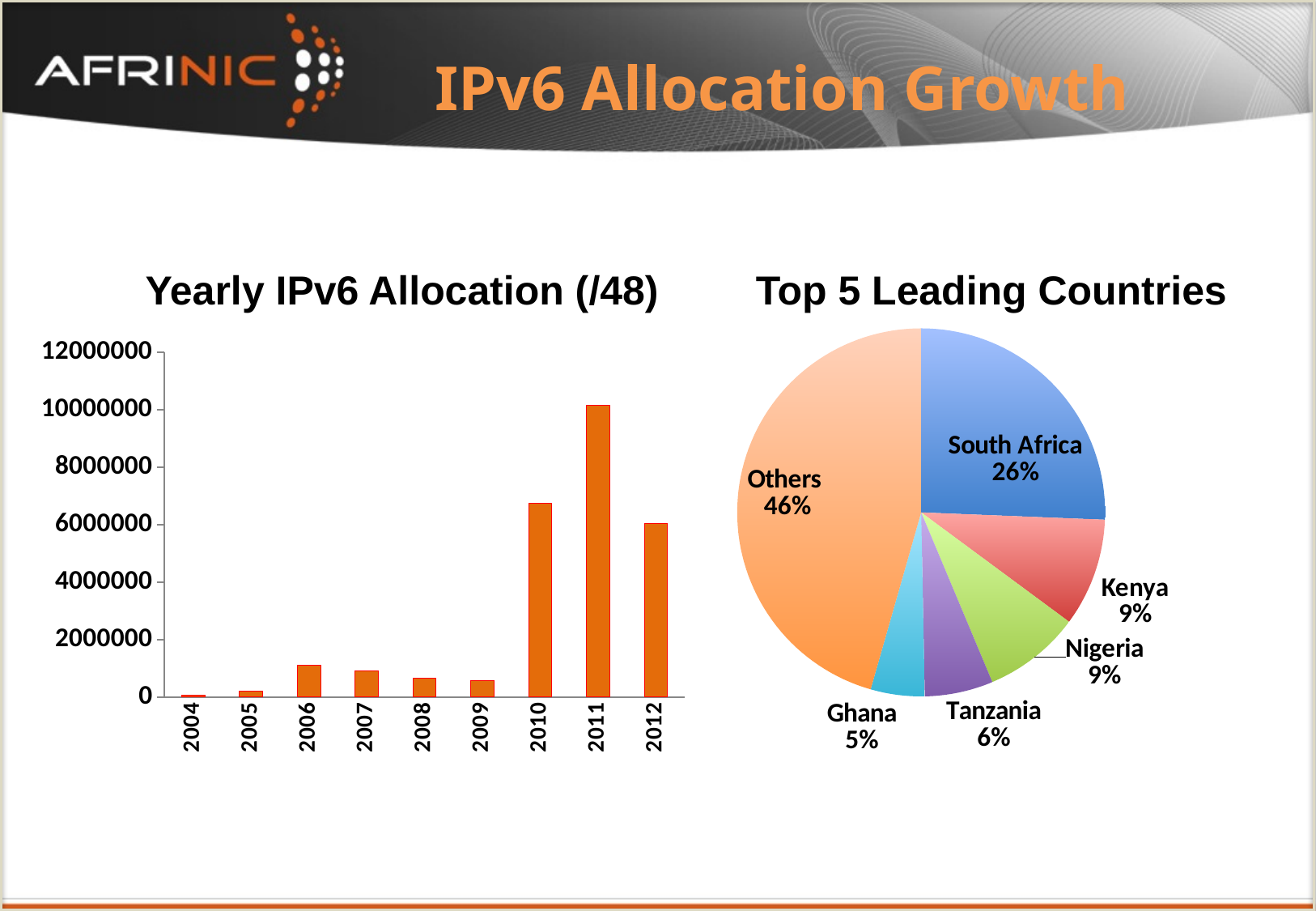
In the Yearly IPv6 Allocation (/48) chart, which year has the lowest bar? 2004 In the Yearly IPv6 Allocation (/48) chart, how many years are shown on the x axis? 9 In the Yearly IPv6 Allocation (/48) chart, is the value for 2006 greater or less than 2000000? less In the Top 5 Leading Countries chart, what is the difference between the South Africa and Ghana shares? 21% In the Top 5 Leading Countries chart, what share does Tanzania have? 6% In the Top 5 Leading Countries chart, how many slices does the pie have? 6 In the Yearly IPv6 Allocation (/48) chart, is the value for 2012 greater or less than 8000000? less In the Top 5 Leading Countries chart, what share does South Africa have? 26% In the Yearly IPv6 Allocation (/48) chart, which year has the highest bar? 2011 What kind of chart is the Yearly IPv6 Allocation (/48) chart? bar chart In the Top 5 Leading Countries chart, which slice is the smallest? Ghana In the Yearly IPv6 Allocation (/48) chart, is the value for 2010 greater or less than 6000000? greater